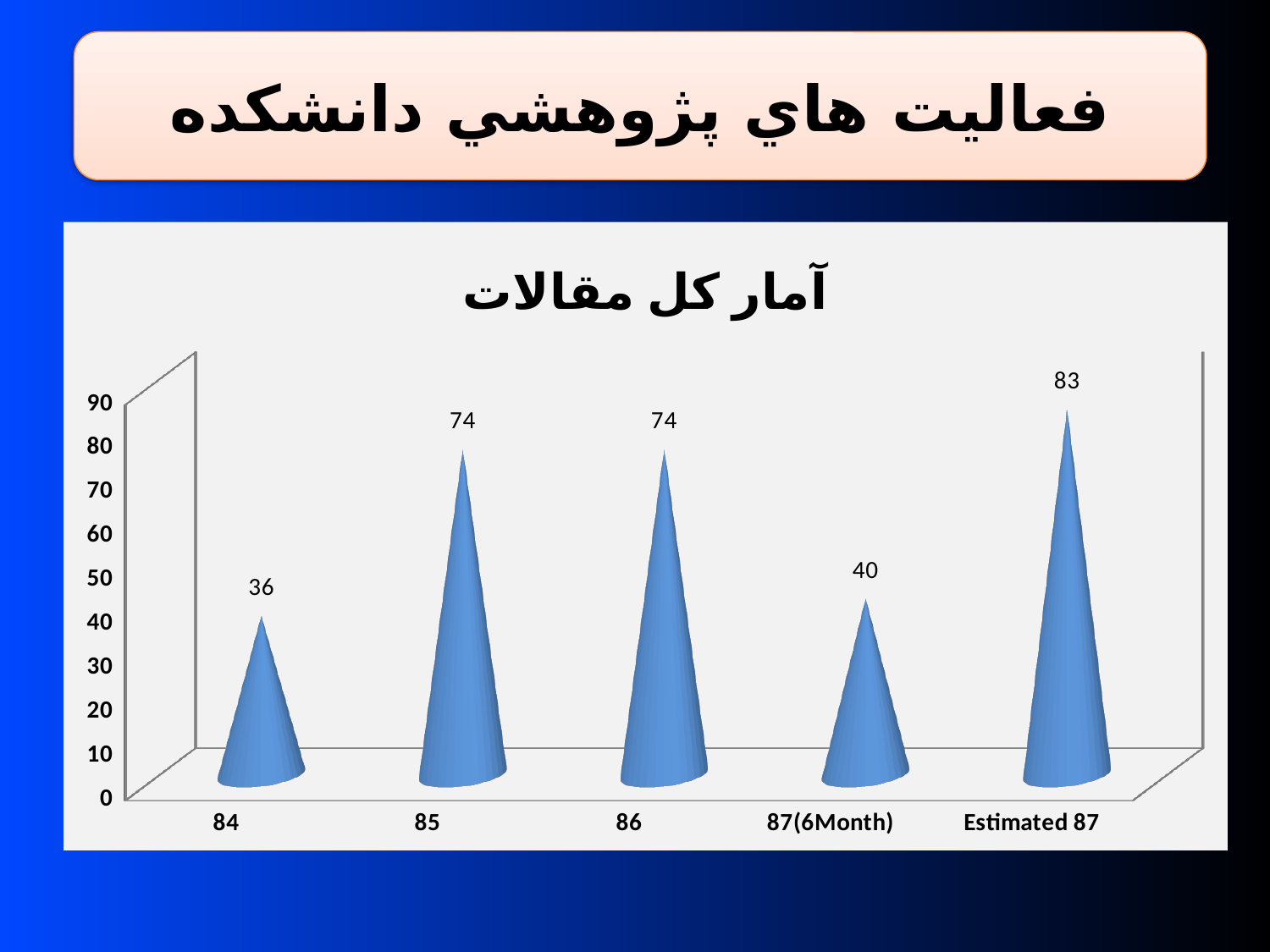
What is the difference between the values for Estimated 87 and 87(6Month)? 43 What is the value for 87(6Month)? 40 Which category has the lowest value? 84 Which is larger, the value for 86 or the value for 87(6Month)? 86 What is the value for 84? 36 How many categories are shown on the x axis? 5 What is the value for Estimated 87? 83 What is the difference between the values for 85 and 84? 38 What is the title of the chart? آمار کل مقالات What kind of chart is shown? bar chart Which category has the highest value? Estimated 87 What is the value for 85? 74